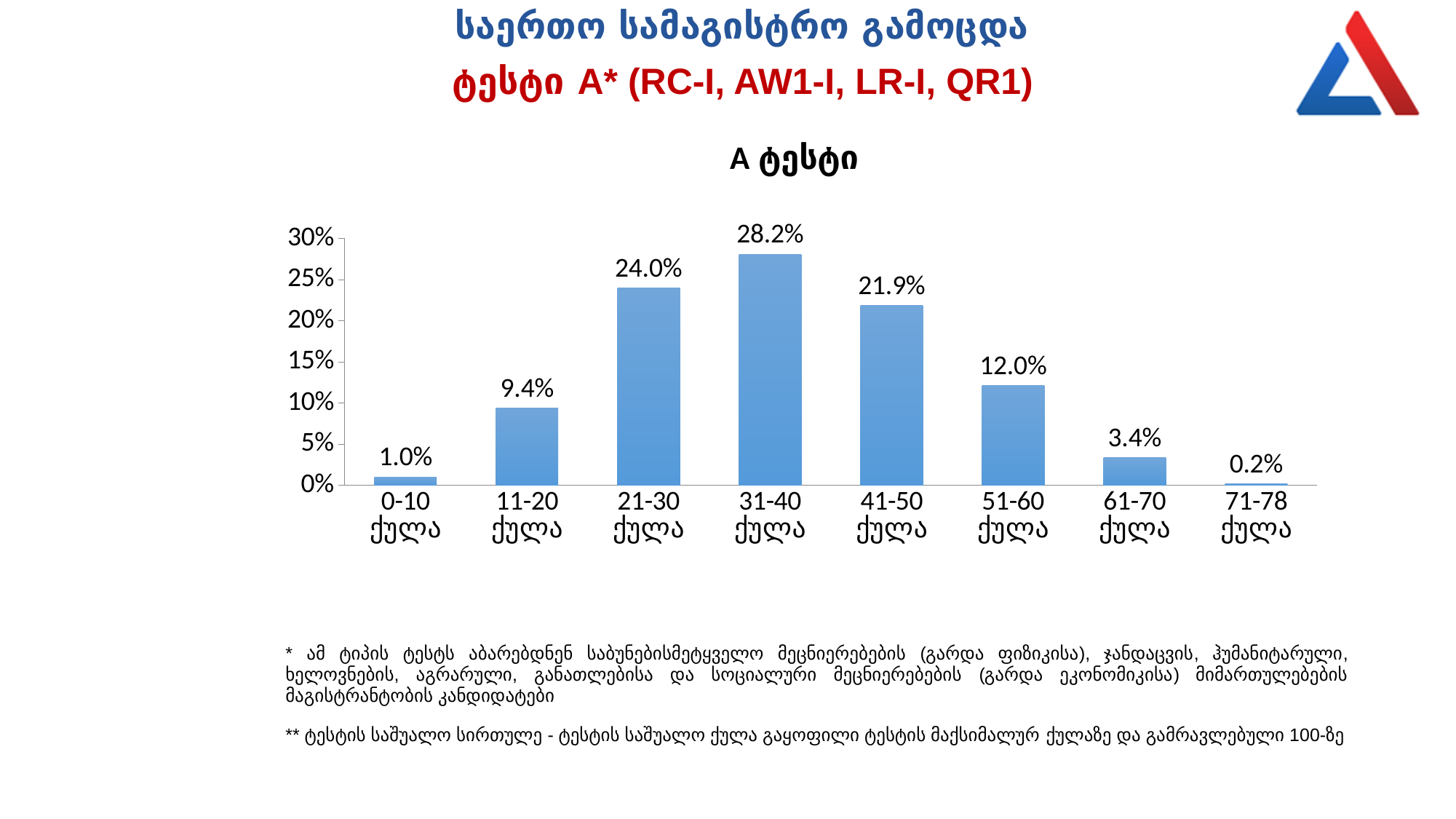
What is the title of the chart? A ტესტი What is the difference between the values for 51-60 ქულა and 0-10 ქულა? 11.0% Which is larger, the value for 11-20 ქულა or the value for 51-60 ქულა? 51-60 ქულა What kind of chart is shown on the slide? bar chart Which category has the highest value? 31-40 ქულა What is the value for the 31-40 ქულა category? 28.2% What is the value for the 11-20 ქულა category? 9.4% Which category has the lowest value? 71-78 ქულა What is the value for the 61-70 ქულა category? 3.4% Is the value for 41-50 ქულა greater or less than 20%? greater What is the difference between the values for 21-30 ქულა and 41-50 ქულა? 2.1% How many categories are shown on the x axis? 8